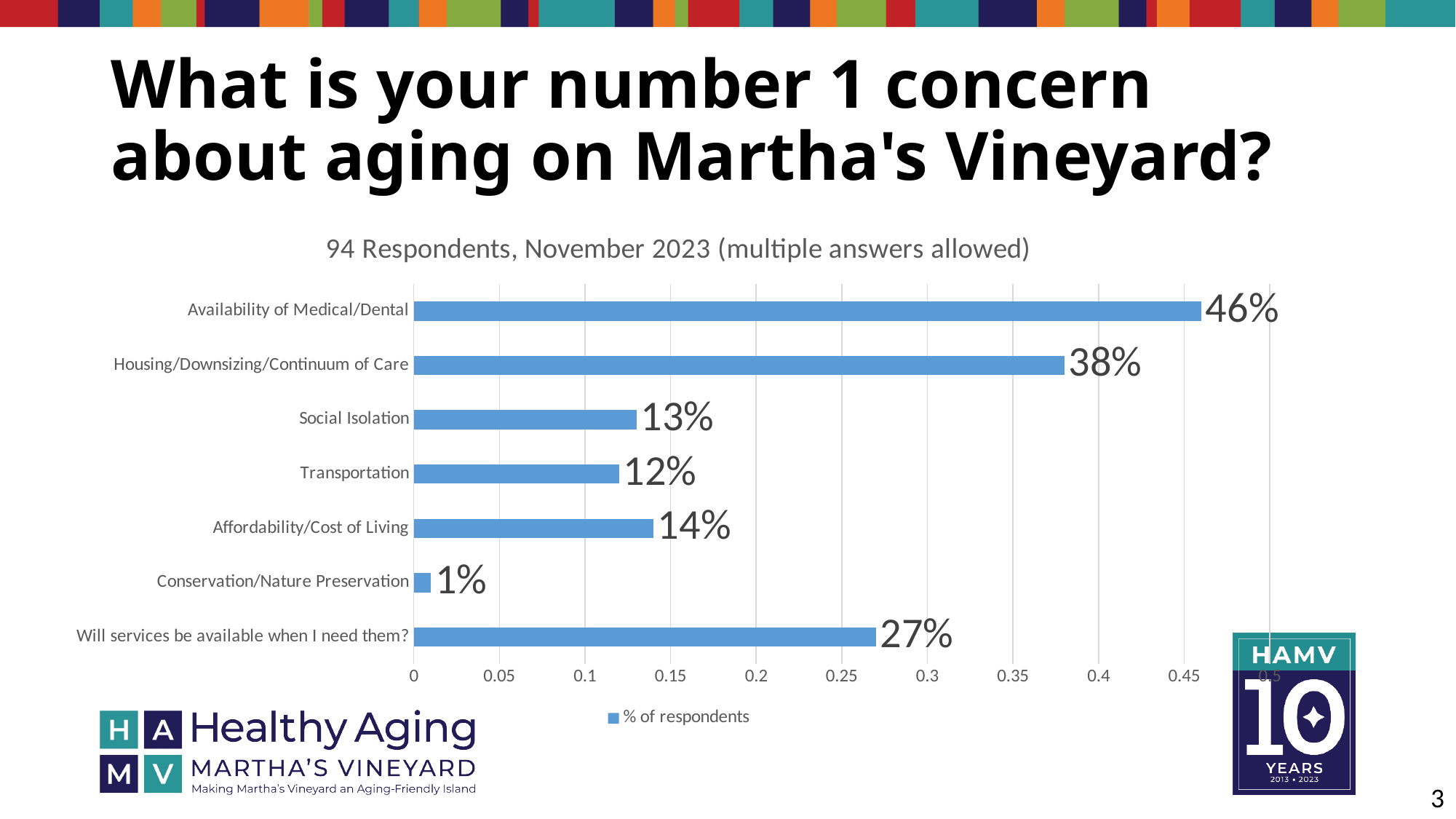
What percentage of respondents cited Availability of Medical/Dental as a concern? 46% How many concern categories are shown in the chart? 7 What is the value for 'Will services be available when I need them?' 27% Which concern has the lowest percentage of respondents? Conservation/Nature Preservation What is the chart's subtitle above the bars? 94 Respondents, November 2023 (multiple answers allowed) Which concern has the highest percentage of respondents? Availability of Medical/Dental Which has a larger value, Social Isolation or Affordability/Cost of Living? Affordability/Cost of Living What type of chart is shown on the slide? Bar chart How many series does the legend list? 1 What is the difference in percentage points between Availability of Medical/Dental and Housing/Downsizing/Continuum of Care? 8 percentage points What percentage of respondents cited Transportation? 12% What is the value for Housing/Downsizing/Continuum of Care? 38%